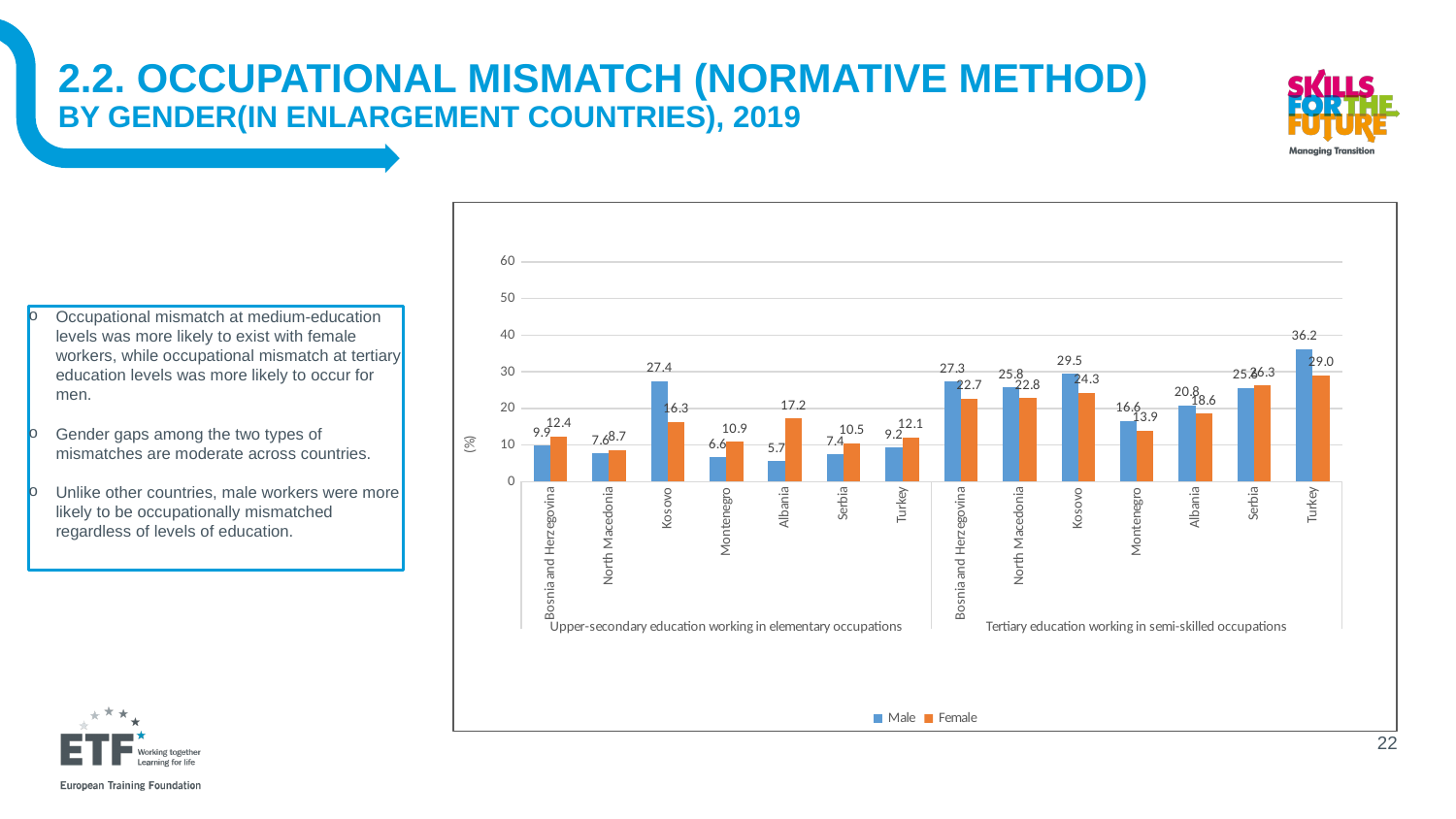
Is the Male value for Turkey in the 'Tertiary education working in semi-skilled occupations' group greater or less than 30? greater Which country has the highest Male value in the 'Tertiary education working in semi-skilled occupations' group? Turkey What is the Male value for Kosovo in the 'Upper-secondary education working in elementary occupations' group? 27.4 What is the Male value for Turkey in the 'Tertiary education working in semi-skilled occupations' group? 36.2 Which country has the lowest Male value in the 'Upper-secondary education working in elementary occupations' group? Albania In the 'Tertiary education working in semi-skilled occupations' group, is the Male or Female value larger for Kosovo? Male What is the Female value for Montenegro in the 'Tertiary education working in semi-skilled occupations' group? 13.9 What is the Female value for Albania in the 'Upper-secondary education working in elementary occupations' group? 17.2 What type of chart is shown on the slide? Bar chart What is the difference between the Female and Male values for Albania in the 'Upper-secondary education working in elementary occupations' group? 11.5 How many countries are shown in each education group on the chart? 7 How many series does the legend list? 2